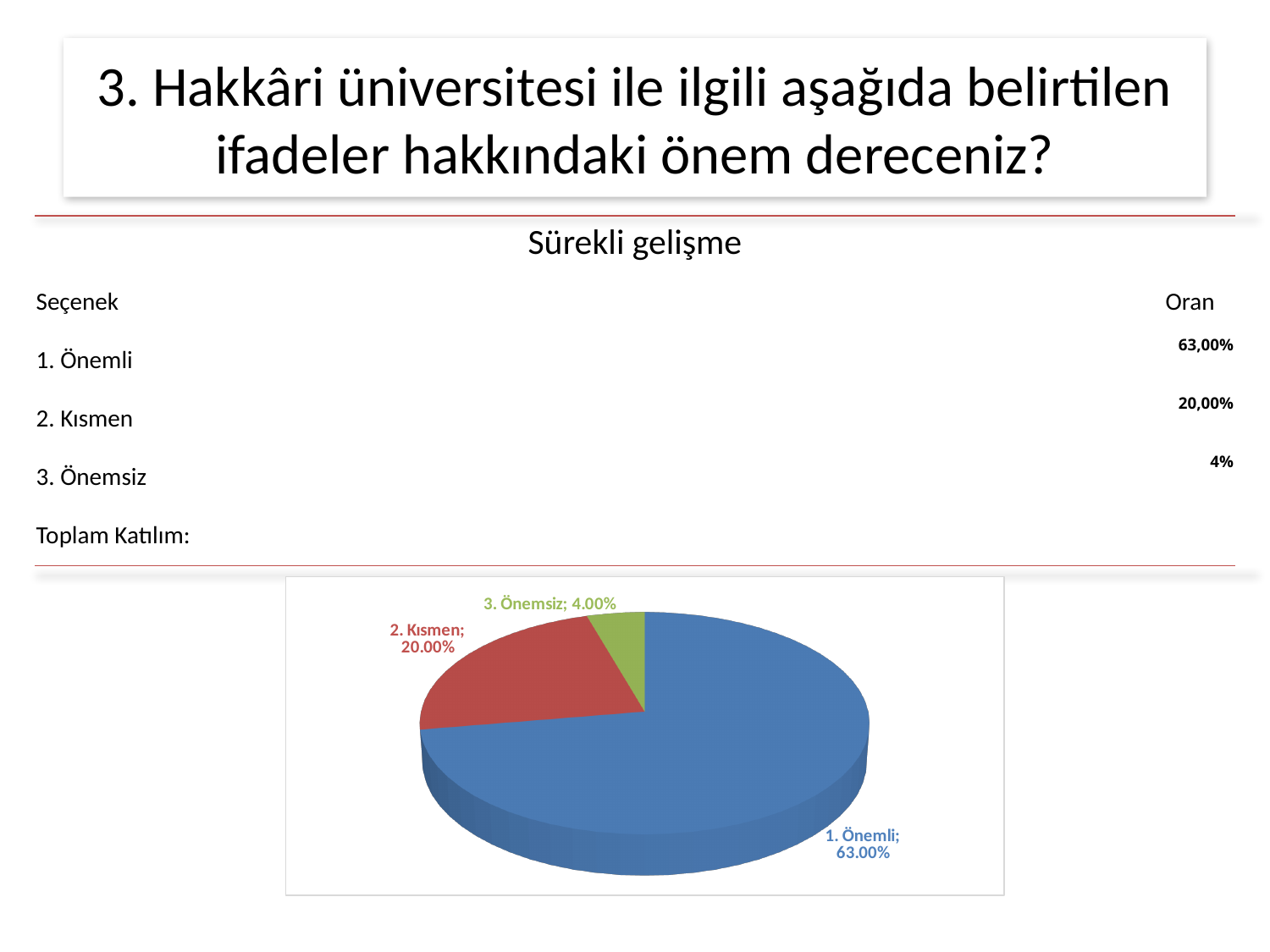
What is the value shown for the slice labelled 1. Önemli? 63.00% What colour is the slice for 2. Kısmen in the pie chart? red How many slices does the pie chart have? 3 What is the value shown for the slice labelled 2. Kısmen? 20.00% Which slice of the pie chart is the largest? 1. Önemli What is the difference between the values for 2. Kısmen and 3. Önemsiz? 16.00% What is the difference between the values for 1. Önemli and 2. Kısmen? 43.00% Which slice of the pie chart is the smallest? 3. Önemsiz Which is larger, the slice for 2. Kısmen or the slice for 3. Önemsiz? 2. Kısmen What is the value shown for the slice labelled 3. Önemsiz? 4.00% What colour is the slice for 1. Önemli in the pie chart? blue What kind of chart is shown on the slide? pie chart